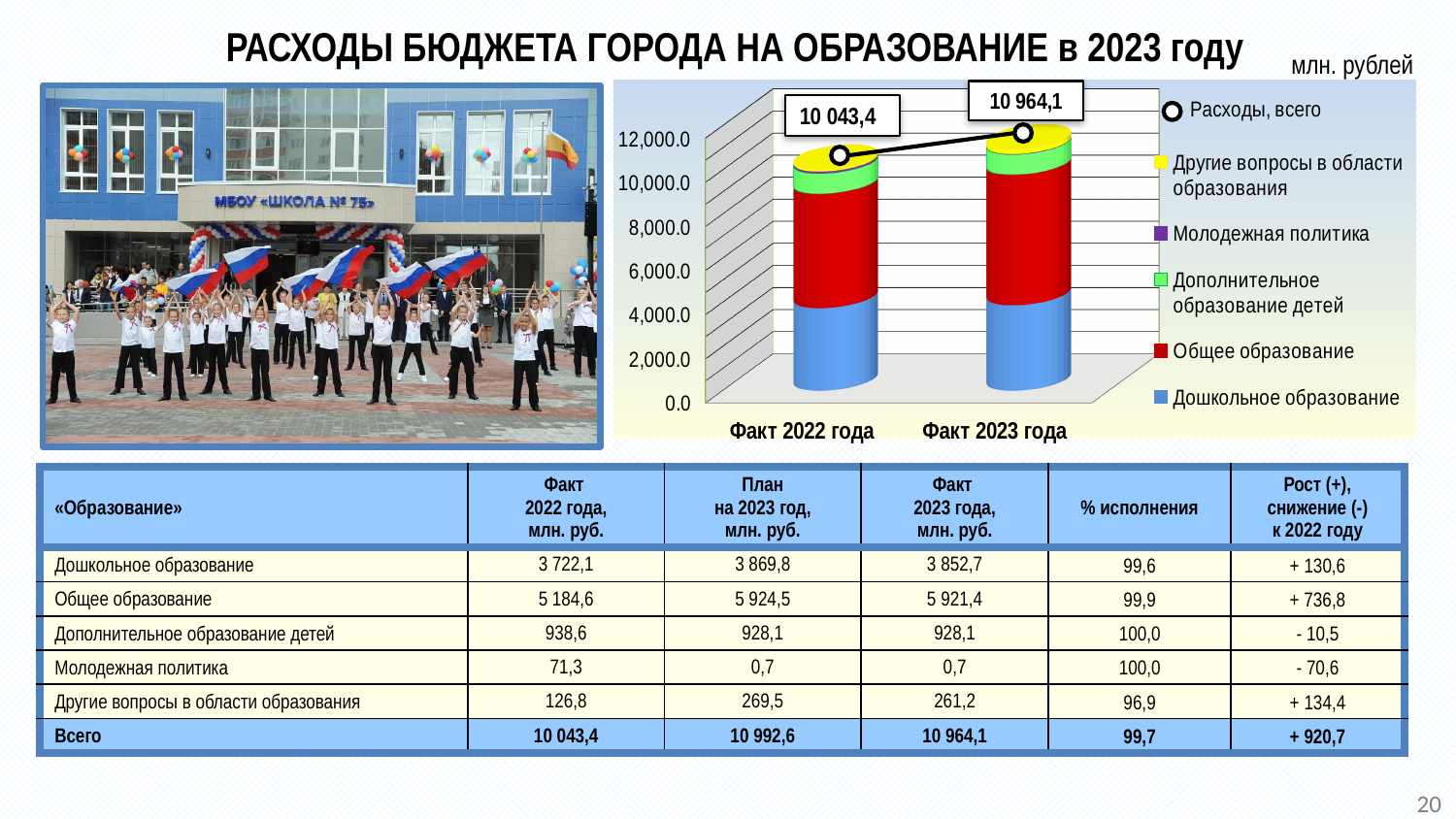
Which legend entry is shown in red in the chart? Общее образование By how much does 'Расходы, всего' for 'Факт 2023 года' exceed 'Факт 2022 года' in the chart? 920,7 Is the 'Дошкольное образование' segment of the 'Факт 2023 года' bar greater or less than 6,000.0? less Does the 'Расходы, всего' line rise or fall from 'Факт 2022 года' to 'Факт 2023 года'? rise What is the value of 'Расходы, всего' for 'Факт 2023 года' in the chart? 10 964,1 What kind of chart is shown on the slide? bar chart What is the value of 'Расходы, всего' for 'Факт 2022 года' in the chart? 10 043,4 Is the total height of the stacked bar for 'Факт 2022 года' greater or less than 8,000.0? greater Which category has the higher value of 'Расходы, всего' in the chart: 'Факт 2022 года' or 'Факт 2023 года'? Факт 2023 года How many categories are shown on the x axis of the chart? 2 What unit is indicated for the chart values in the top right of the slide? млн. рублей How many series does the chart legend list? 6